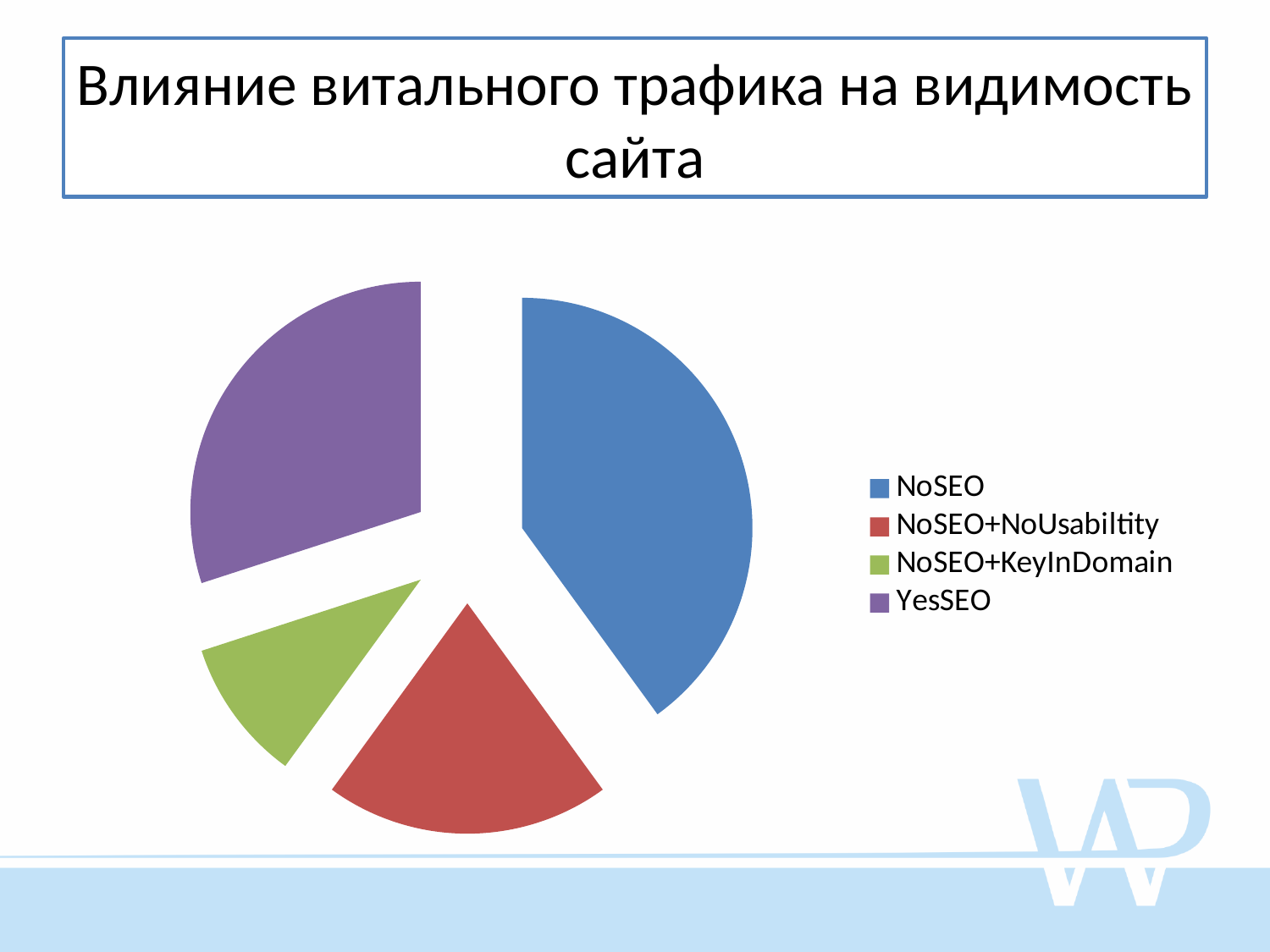
Which slice is larger, NoSEO or NoSEO+NoUsabiltity? NoSEO Which category has the smallest slice in the pie chart? NoSEO+KeyInDomain Which slice is larger, NoSEO+NoUsabiltity or NoSEO+KeyInDomain? NoSEO+NoUsabiltity How many entries does the legend of the pie chart list? 4 What is the title of the slide containing the pie chart? Влияние витального трафика на видимость сайта How many slices does the pie chart have? 4 What kind of chart is shown on the slide? pie chart What colour is the YesSEO slice in the pie chart? purple Which slice is larger, YesSEO or NoSEO+NoUsabiltity? YesSEO Which category has the largest slice in the pie chart? NoSEO